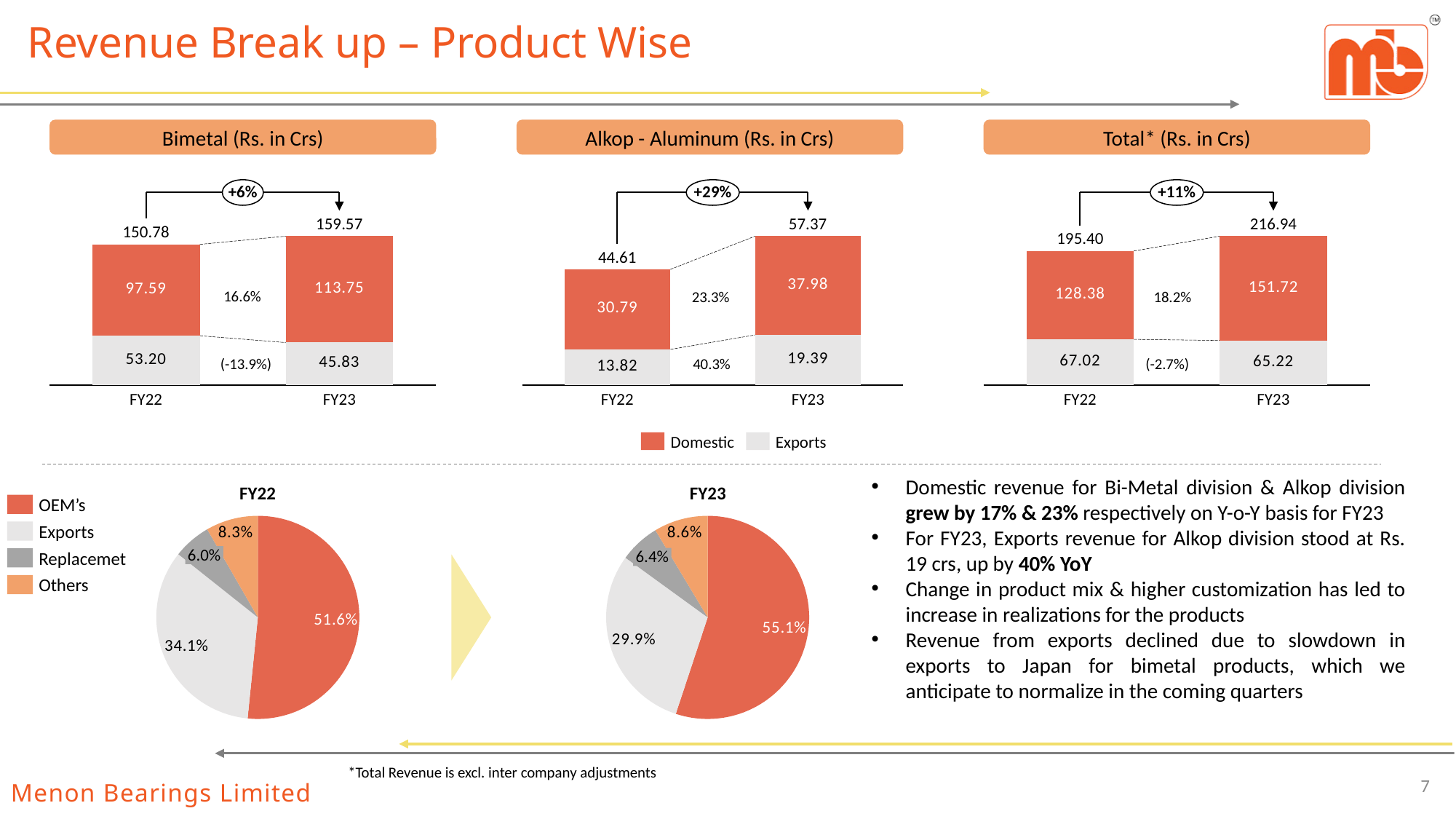
In the Bimetal (Rs. in Crs) chart, what is the Domestic value for FY23? 113.75 In the Bimetal (Rs. in Crs) chart, what is the difference between the Exports values for FY22 and FY23? 7.37 In the FY22 pie chart, what share does Exports have? 34.1% How many series does the legend list for the stacked bar charts? 2 What kind of chart is the Bimetal (Rs. in Crs) chart? Stacked bar chart In the Total* (Rs. in Crs) chart, what is the Exports value for FY22? 67.02 In the Alkop - Aluminum (Rs. in Crs) chart, what is the Exports value for FY22? 13.82 How many categories does the FY23 pie chart show? 4 In the FY22 pie chart, which category has the smallest share? Replacemet In the Total* (Rs. in Crs) chart, what is the total of the FY23 stacked bar? 216.94 In the Alkop - Aluminum (Rs. in Crs) chart, which year has the higher Domestic value, FY22 or FY23? FY23 In the FY23 pie chart, which category has the largest share? OEM's